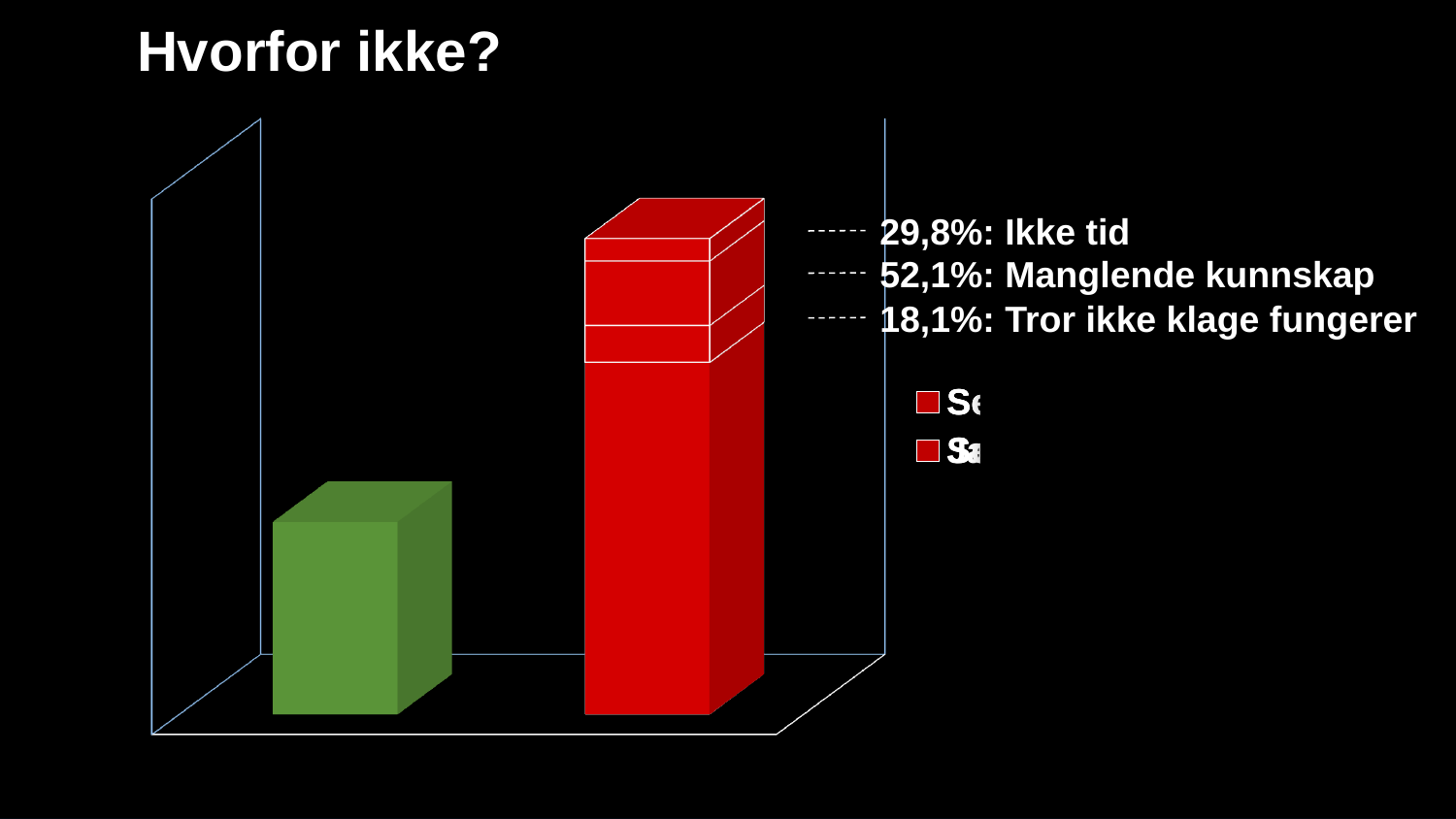
What is the difference between the percentages for 'Manglende kunnskap' and 'Ikke tid'? 22,3% What percentage is given for 'Ikke tid' in the chart annotations? 29,8% Which bar is taller, the green bar on the left or the red bar on the right? the red bar on the right Which of the three annotated reasons has the lowest percentage? Tror ikke klage fungerer Which of the three annotated reasons has the highest percentage? Manglende kunnskap What is the title of the slide above the chart? Hvorfor ikke? What percentage is given for 'Tror ikke klage fungerer' in the chart annotations? 18,1% What kind of chart is shown on the slide? bar chart What percentage is given for 'Manglende kunnskap' in the chart annotations? 52,1% What colour is the shorter bar in the chart? green How many bars are plotted in the chart? 2 Which is larger, the percentage for 'Ikke tid' or for 'Tror ikke klage fungerer'? Ikke tid